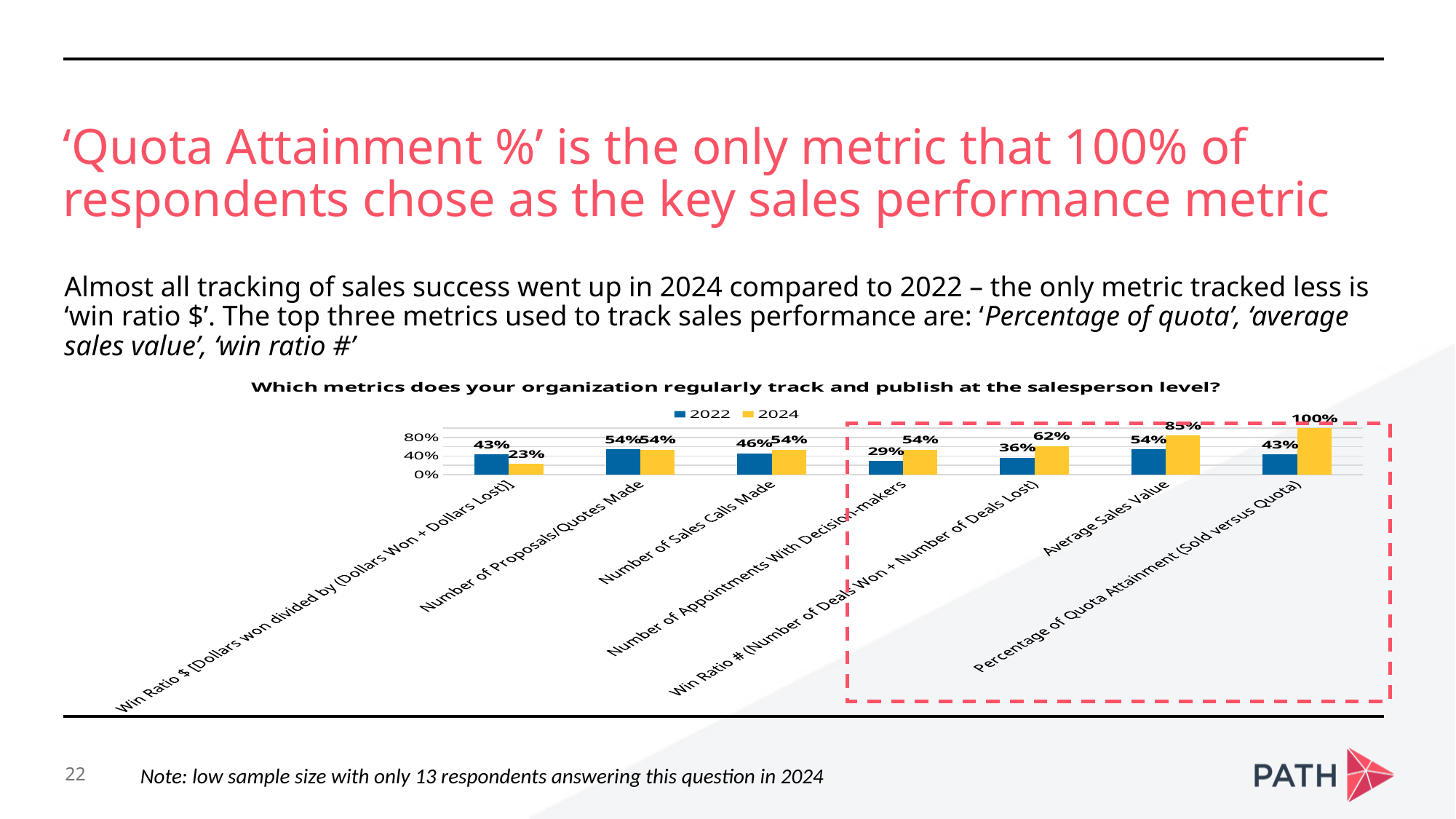
What kind of chart is shown on the slide? Bar chart What is the 2022 value for Number of Appointments With Decision-makers? 29% What is the difference between the 2024 and 2022 values for Average Sales Value? 31% What is the title of the chart? Which metrics does your organization regularly track and publish at the salesperson level? How many categories are shown on the x axis? 7 Which category has the lowest 2024 value? Win Ratio $ [Dollars won divided by (Dollars Won + Dollars Lost)] For Win Ratio # (Number of Deals Won + Number of Deals Lost), which is larger: the 2022 value or the 2024 value? 2024 What is the 2024 value for Average Sales Value? 85% How many series does the legend list? 2 What is the 2022 value for Win Ratio $ [Dollars won divided by (Dollars Won + Dollars Lost)]? 43% Which category has the highest 2024 value? Percentage of Quota Attainment (Sold versus Quota) What is the 2024 value for Percentage of Quota Attainment (Sold versus Quota)? 100%